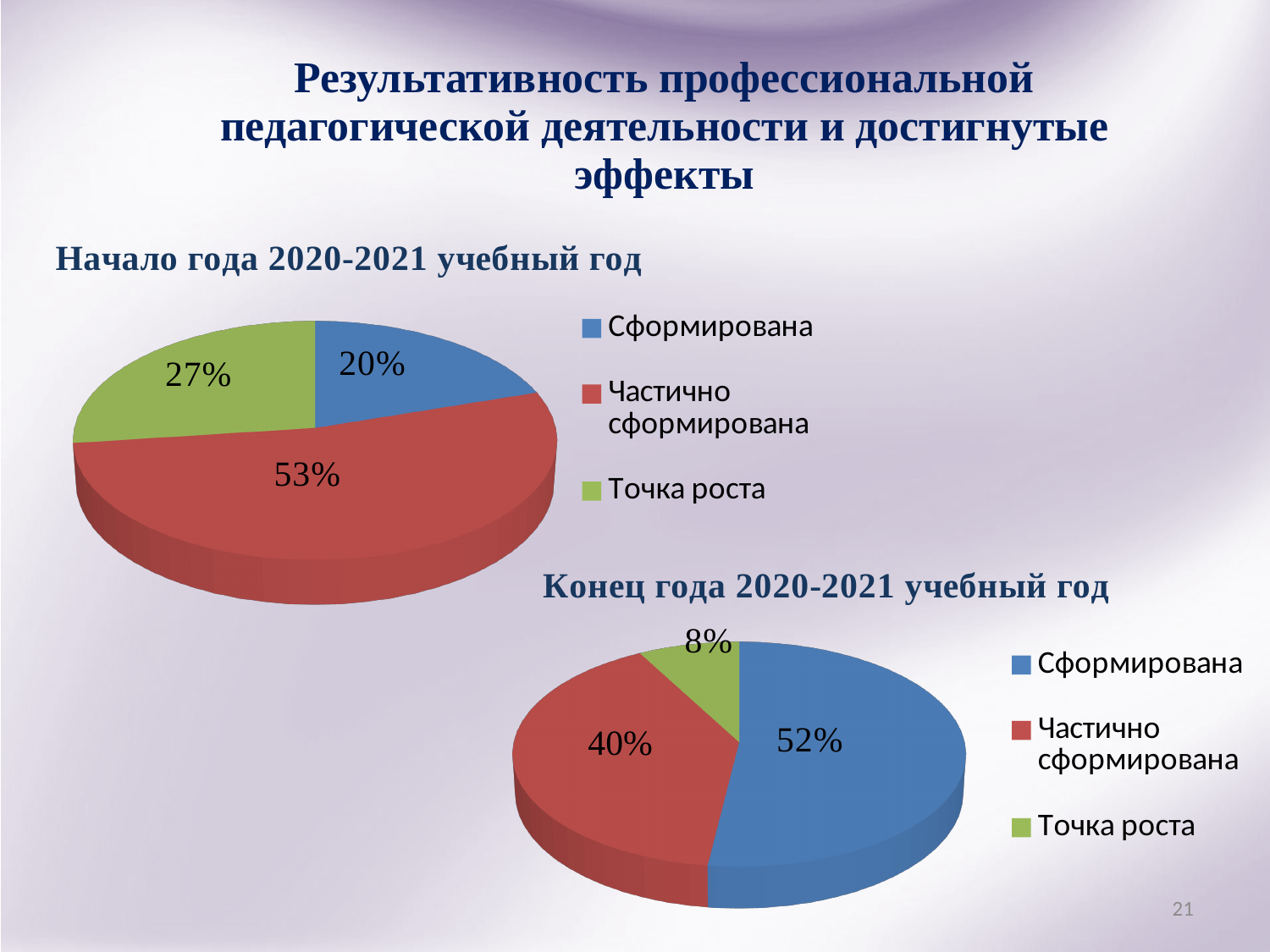
In the 'Начало года 2020-2021 учебный год' chart, what share does 'Частично сформирована' have? 53% In the 'Конец года 2020-2021 учебный год' chart, what is the difference between 'Сформирована' and 'Частично сформирована'? 12% In the 'Конец года 2020-2021 учебный год' chart, what share does 'Точка роста' have? 8% How many slices does the 'Конец года 2020-2021 учебный год' chart have? 3 In the 'Начало года 2020-2021 учебный год' chart, which is larger: 'Точка роста' or 'Сформирована'? Точка роста In the 'Конец года 2020-2021 учебный год' chart, which category has the smallest slice? Точка роста In the 'Конец года 2020-2021 учебный год' chart, what share does 'Сформирована' have? 52% What type of chart is the 'Начало года 2020-2021 учебный год' chart? Pie chart In the 'Начало года 2020-2021 учебный год' chart, what share does 'Точка роста' have? 27% In the 'Начало года 2020-2021 учебный год' chart, what share does 'Сформирована' have? 20% In the 'Конец года 2020-2021 учебный год' chart, what colour is the 'Частично сформирована' slice? Red In the 'Начало года 2020-2021 учебный год' chart, which category has the largest slice? Частично сформирована